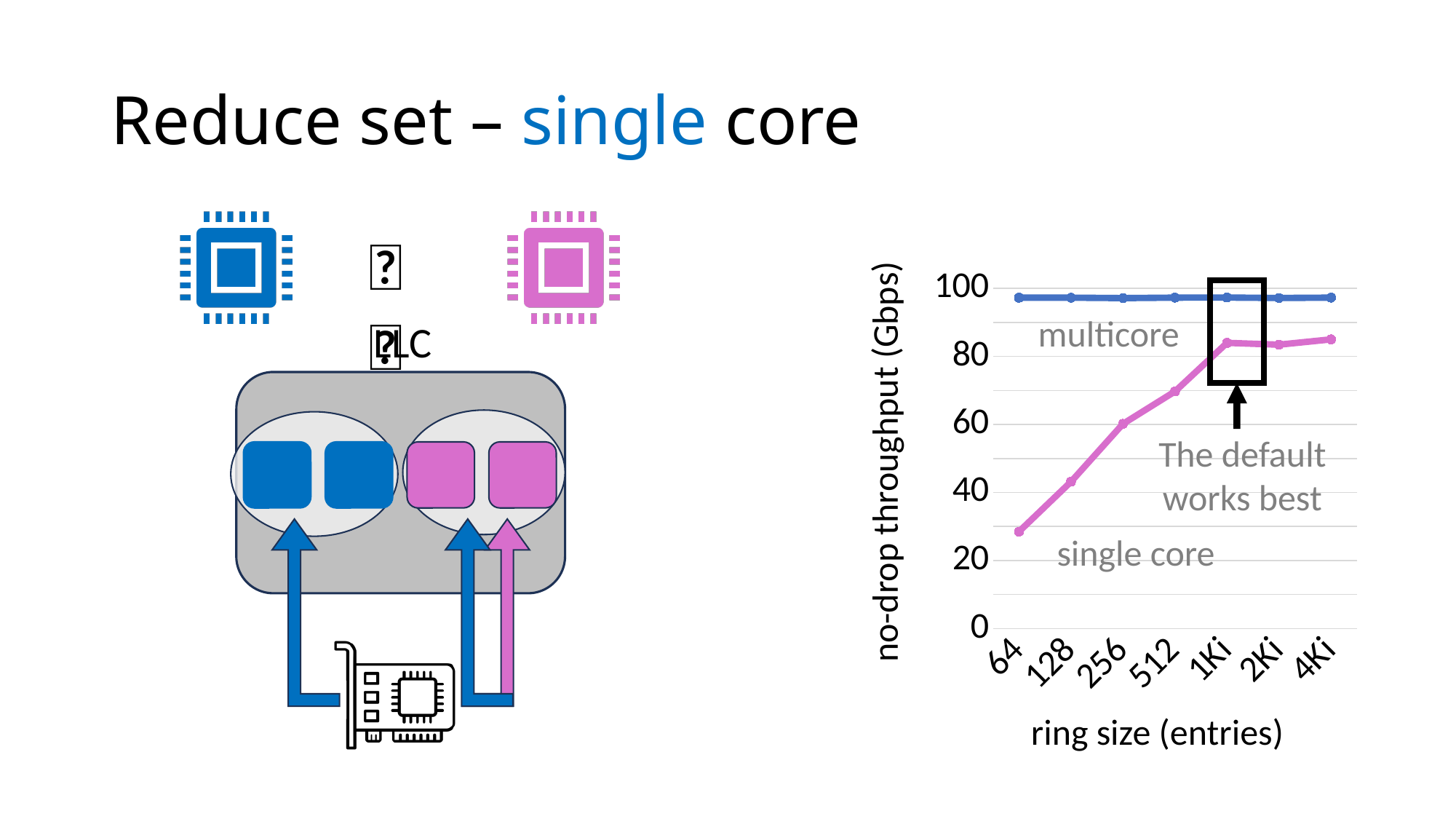
How many series are plotted in the chart? 2 What is the label of the x axis? ring size (entries) Is the single core value at ring size 256 greater or less than 40? greater Is the multicore value at ring size 64 greater or less than 80? greater What kind of chart is shown on the slide? line chart Does the single core throughput rise or fall as ring size increases from 64 to 1Ki? rise Is the single core value at ring size 4Ki greater or less than 60? greater At ring size 64, which series has the higher throughput, multicore or single core? multicore How many ring size values are plotted along the x axis? 7 What is the label of the y axis? no-drop throughput (Gbps)